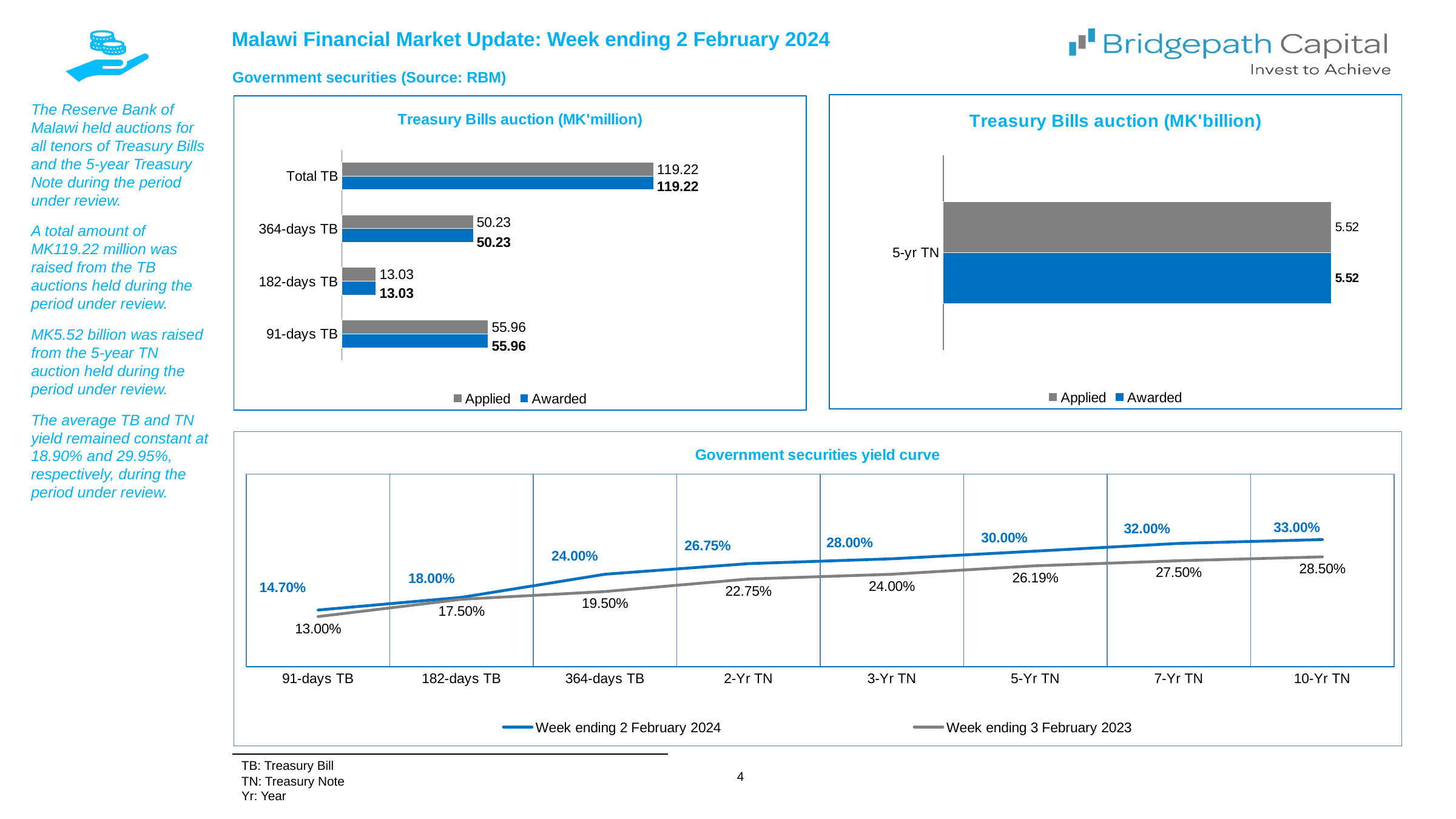
In the 'Treasury Bills auction (MK'million)' chart, what is the difference between the Awarded values for 91-days TB and 364-days TB? 5.73 In the 'Government securities yield curve' chart, how many tenors are shown on the x axis? 8 In the 'Treasury Bills auction (MK'billion)' chart, what is the Awarded value for 5-yr TN? 5.52 In the 'Government securities yield curve' chart, do the yields for the week ending 2 February 2024 rise or fall from 91-days TB to 10-Yr TN? Rise In the 'Government securities yield curve' chart, what is the yield for 364-days TB for the week ending 3 February 2023? 19.50% In the 'Treasury Bills auction (MK'million)' chart, what is the Awarded value for 364-days TB? 50.23 What kind of chart is the 'Treasury Bills auction (MK'billion)' chart? Bar chart In the 'Treasury Bills auction (MK'million)' chart, what is the Applied value for 182-days TB? 13.03 In the 'Government securities yield curve' chart, what is the yield for 2-Yr TN for the week ending 2 February 2024? 26.75% In the 'Treasury Bills auction (MK'million)' chart, which tenor has the lowest Applied value? 182-days TB In the 'Treasury Bills auction (MK'million)' chart, how many series does the legend list? 2 In the 'Treasury Bills auction (MK'million)' chart, which tenor (excluding Total TB) has the highest Awarded value? 91-days TB